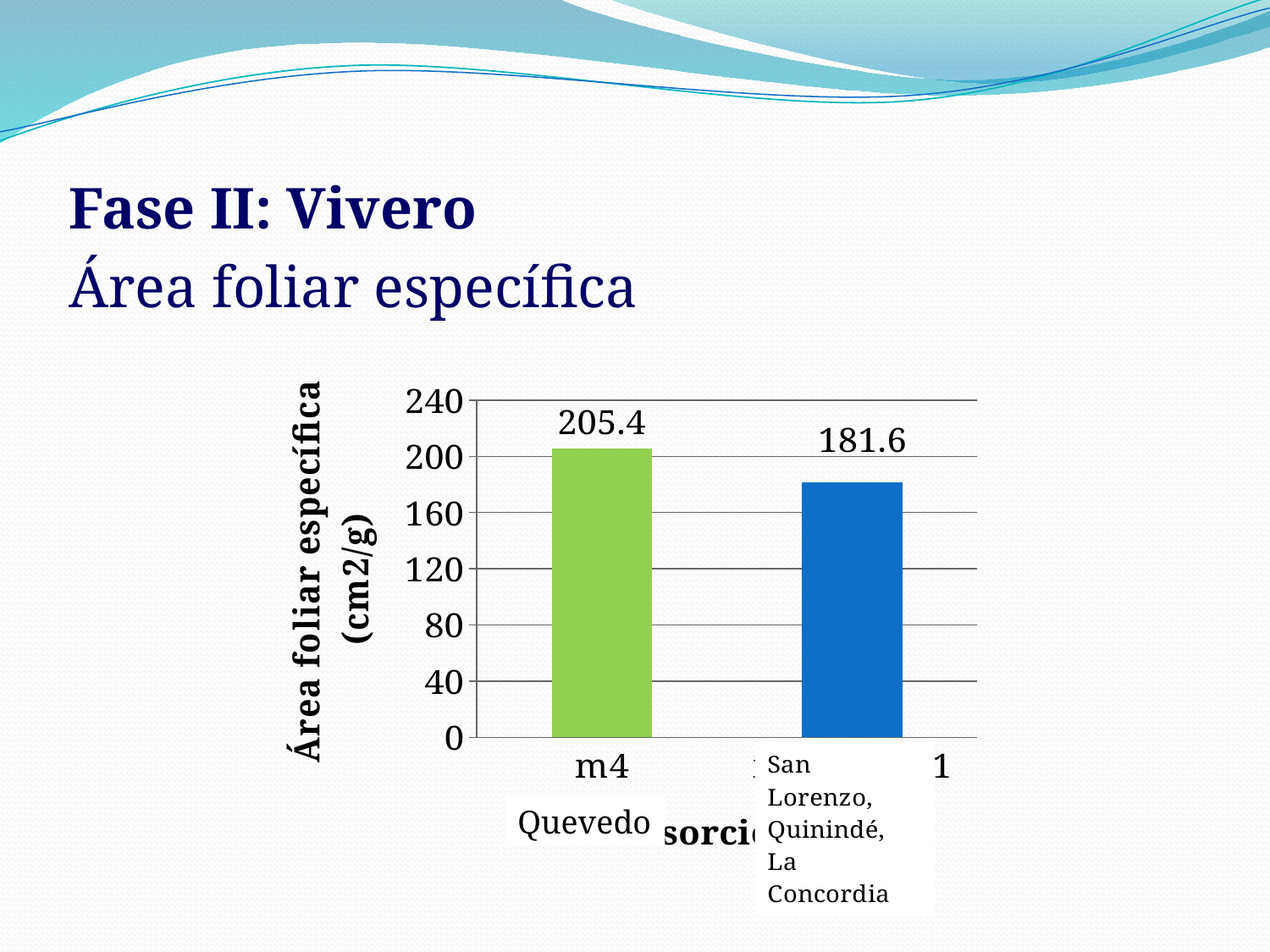
Is the value for the Quevedo bar greater or less than 200? greater What is the value of the right bar, labelled San Lorenzo, Quinindé, La Concordia? 181.6 What colour is the left bar (Quevedo)? green What is the value of the left bar, labelled Quevedo? 205.4 What is the title of the vertical axis? Área foliar específica (cm2/g) What kind of chart is shown on the slide? bar chart How many bars are plotted in the chart? 2 Which is larger, the value for Quevedo or the value for San Lorenzo, Quinindé, La Concordia? Quevedo What is the difference between the Quevedo bar and the San Lorenzo, Quinindé, La Concordia bar? 23.8 Which bar has the highest value? Quevedo (left bar) Is the value for the San Lorenzo, Quinindé, La Concordia bar greater or less than 200? less Which bar has the lowest value? San Lorenzo, Quinindé, La Concordia (right bar)